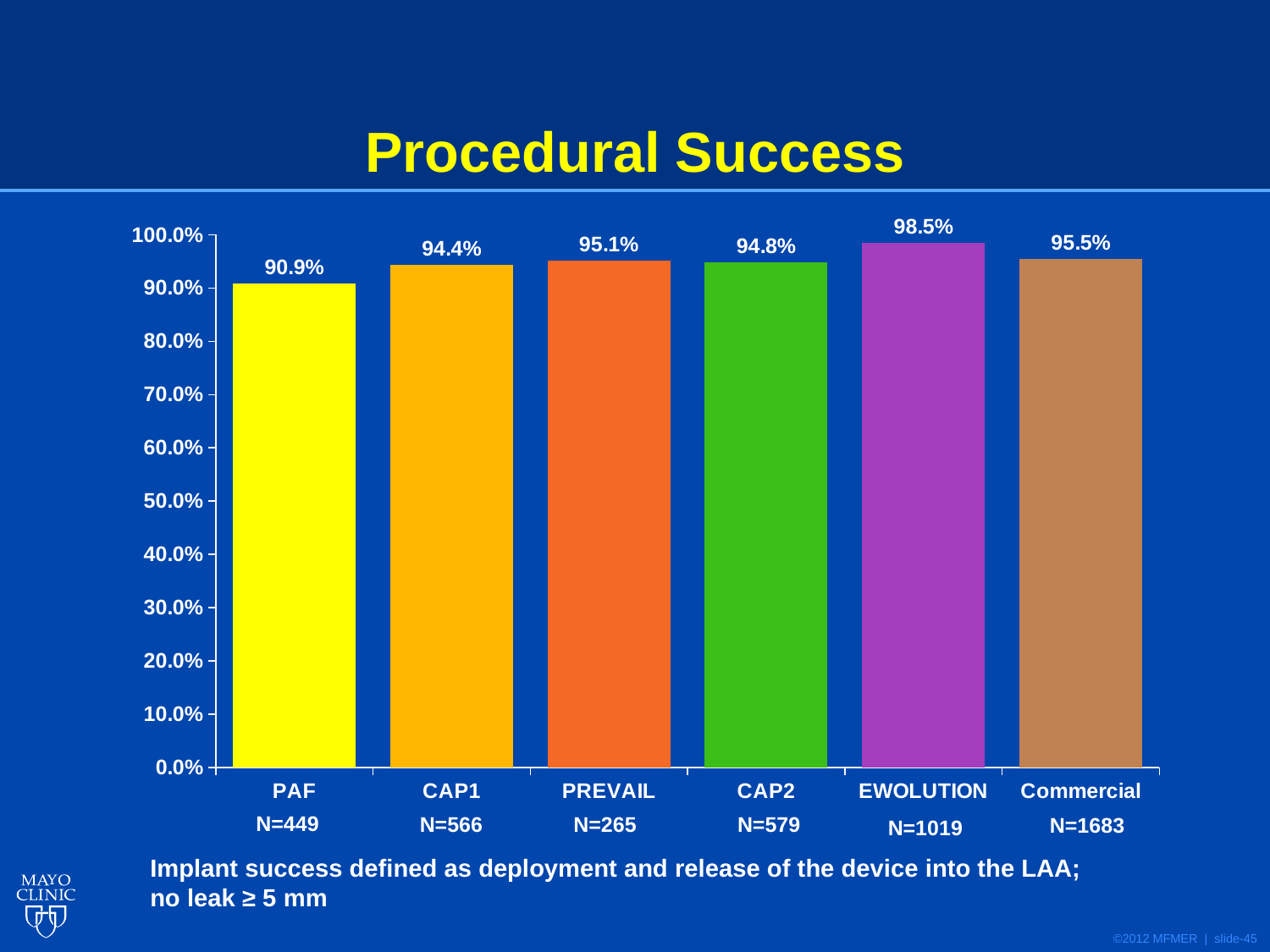
What is the procedural success rate for EWOLUTION? 98.5% What is the procedural success rate for PAF? 90.9% What kind of chart is shown on the slide? Bar chart Which has a higher procedural success rate, CAP1 or PREVAIL? PREVAIL What is the difference in procedural success rate between EWOLUTION and PAF? 7.6% What is the procedural success rate for Commercial? 95.5% How many studies are shown on the chart? 6 What is the title of the chart? Procedural Success Which study has the highest procedural success rate? EWOLUTION What is the difference in procedural success rate between Commercial and CAP1? 1.1% Which study has the lowest procedural success rate? PAF Is the value for CAP2 greater or less than 90.0%? greater